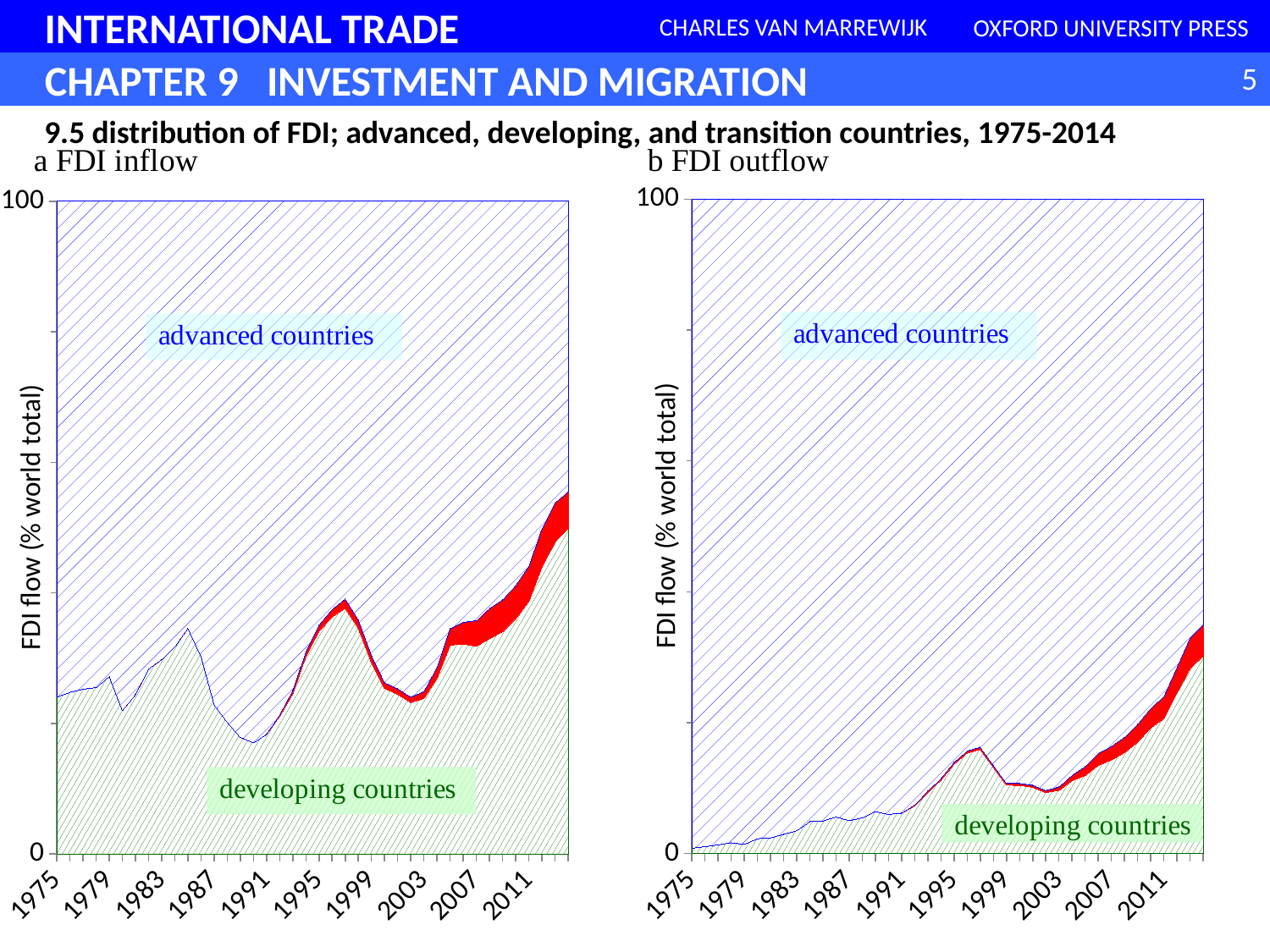
What kind of chart is the 'a FDI inflow' chart? stacked area chart In the 'b FDI outflow' chart, does the share of developing countries rise or fall between 1975 and 2014? rise In the 'a FDI inflow' chart, which group has the largest share of world FDI in 1975? advanced countries What is the y-axis label on the 'a FDI inflow' chart? FDI flow (% world total) In the 'b FDI outflow' chart, which group has the largest share of world FDI in 2014? advanced countries In 2014, is the developing countries' share larger in the 'a FDI inflow' chart or in the 'b FDI outflow' chart? a FDI inflow What is the highest value shown on the y axis of the 'b FDI outflow' chart? 100 In the 'a FDI inflow' chart, is the share of developing countries larger in 1975 or in 2014? 2014 In the 'b FDI outflow' chart, is the share of developing countries larger in 1975 or in 2014? 2014 What kind of chart is the 'b FDI outflow' chart? stacked area chart How many year labels are printed on the x axis of the 'a FDI inflow' chart? 10 What is the title of the figure shown on the slide? 9.5 distribution of FDI; advanced, developing, and transition countries, 1975-2014